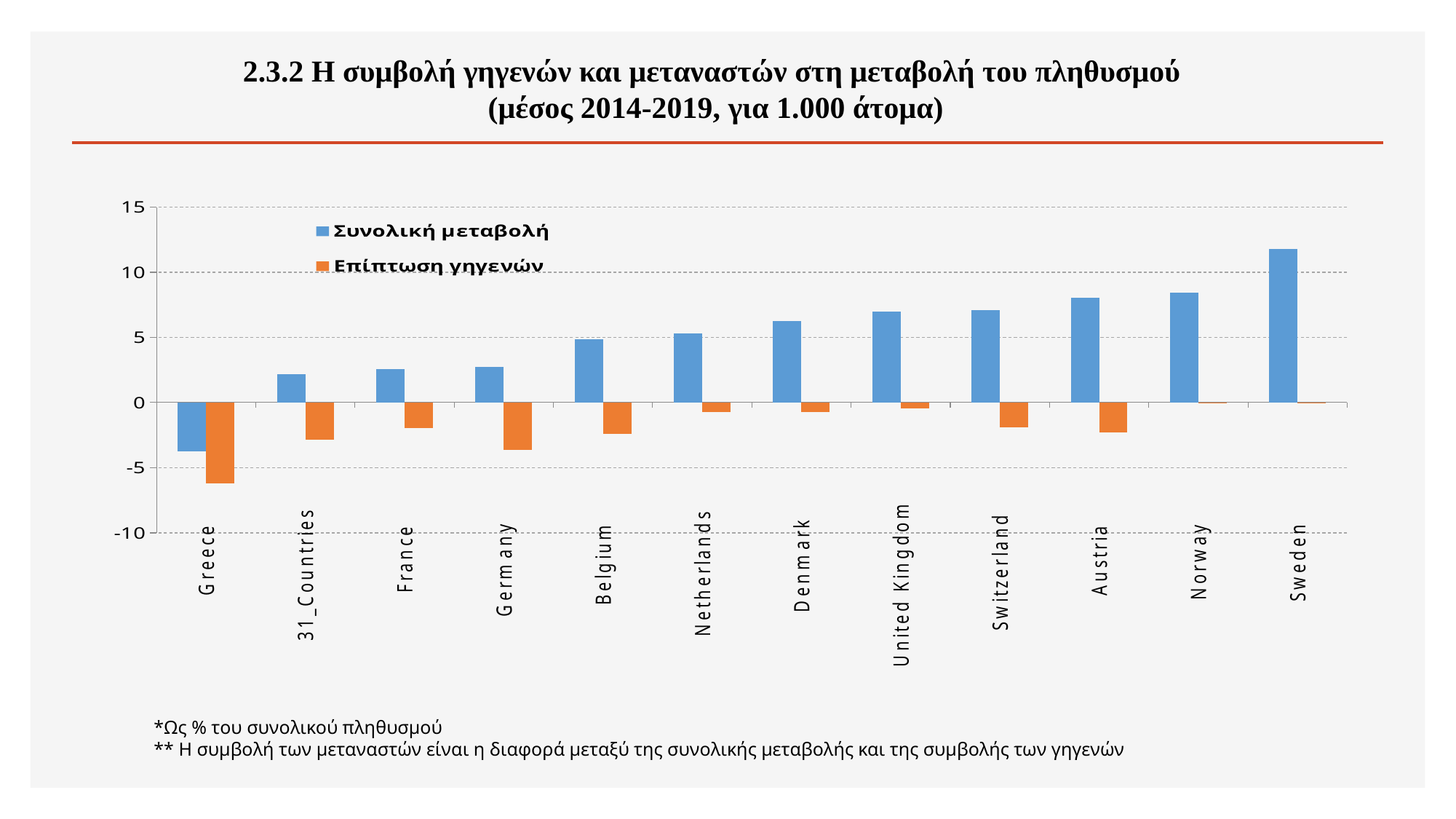
Which category has the highest value for Συνολική μεταβολή? Sweden What kind of chart is shown on the slide? bar chart Is the Συνολική μεταβολή value for Denmark greater or less than 5? greater Is the Συνολική μεταβολή value for Sweden greater or less than 10? greater Is the Επίπτωση γηγενών value for Greece greater or less than -5? less Which category has the lowest value for Επίπτωση γηγενών? Greece How many series does the legend list? 2 Which category has the lowest value for Συνολική μεταβολή? Greece Which series is shown in orange? Επίπτωση γηγενών Which has a larger Συνολική μεταβολή value, Austria or Belgium? Austria How many countries/categories are shown on the x axis? 12 Do the Συνολική μεταβολή values rise or fall from left to right along the x axis? rise